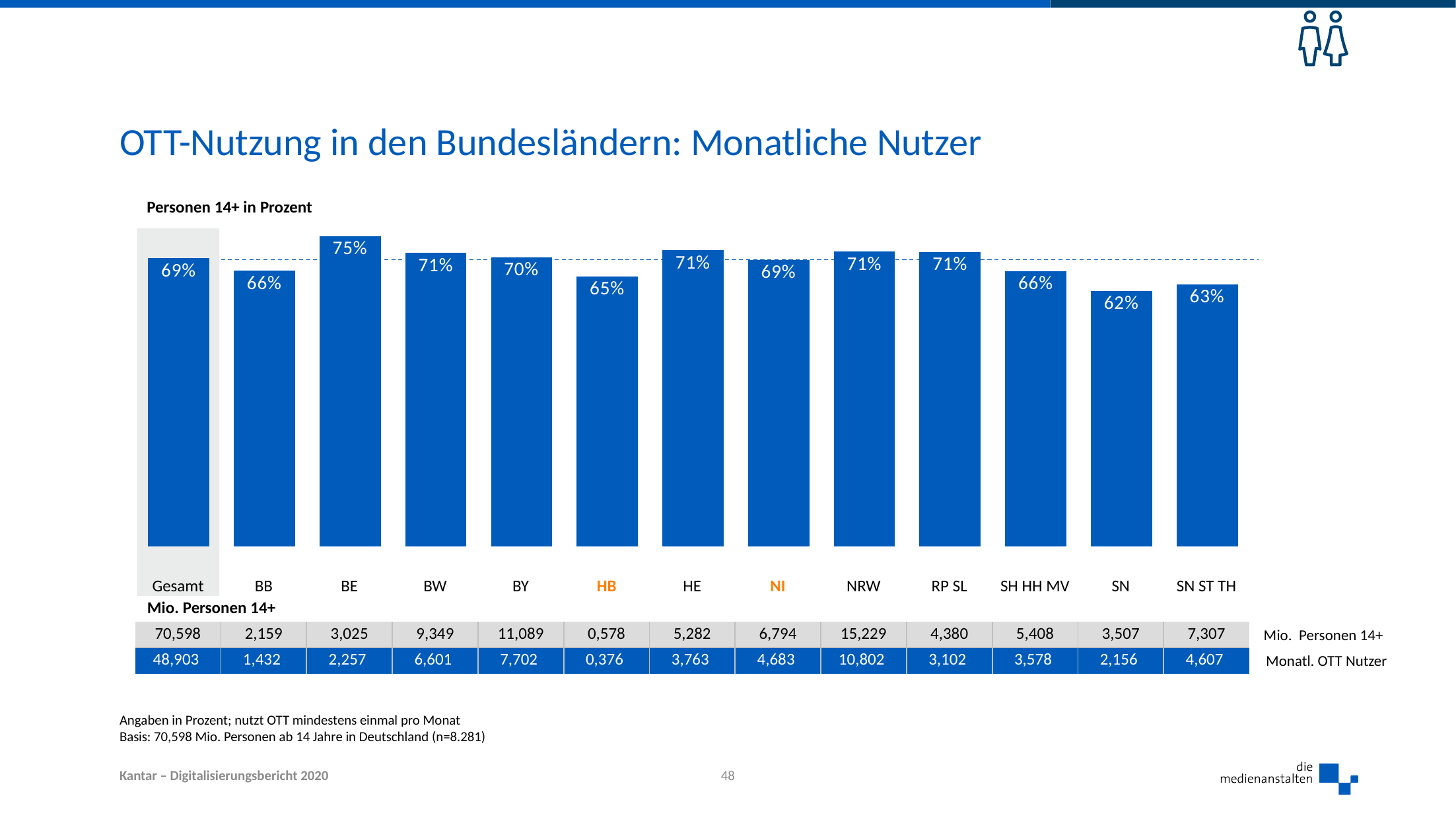
What is the value shown for SN in the bar chart? 62% What kind of chart is shown on the slide? bar chart According to the table, how many million monthly OTT users are there in NRW? 10,802 Which has a higher percentage, BY or HB? BY Which two category labels on the x axis are highlighted in orange? HB and NI What percentage of persons 14+ in BE are monthly OTT users? 75% Which category has the lowest percentage in the bar chart? SN How many bars are shown in the chart, including Gesamt? 13 What is the difference in percentage points between BE and SN? 13 What is the value shown for Gesamt in the bar chart? 69% Which category has the highest percentage in the bar chart? BE According to the table, how many million persons 14+ are there in BY? 11,089